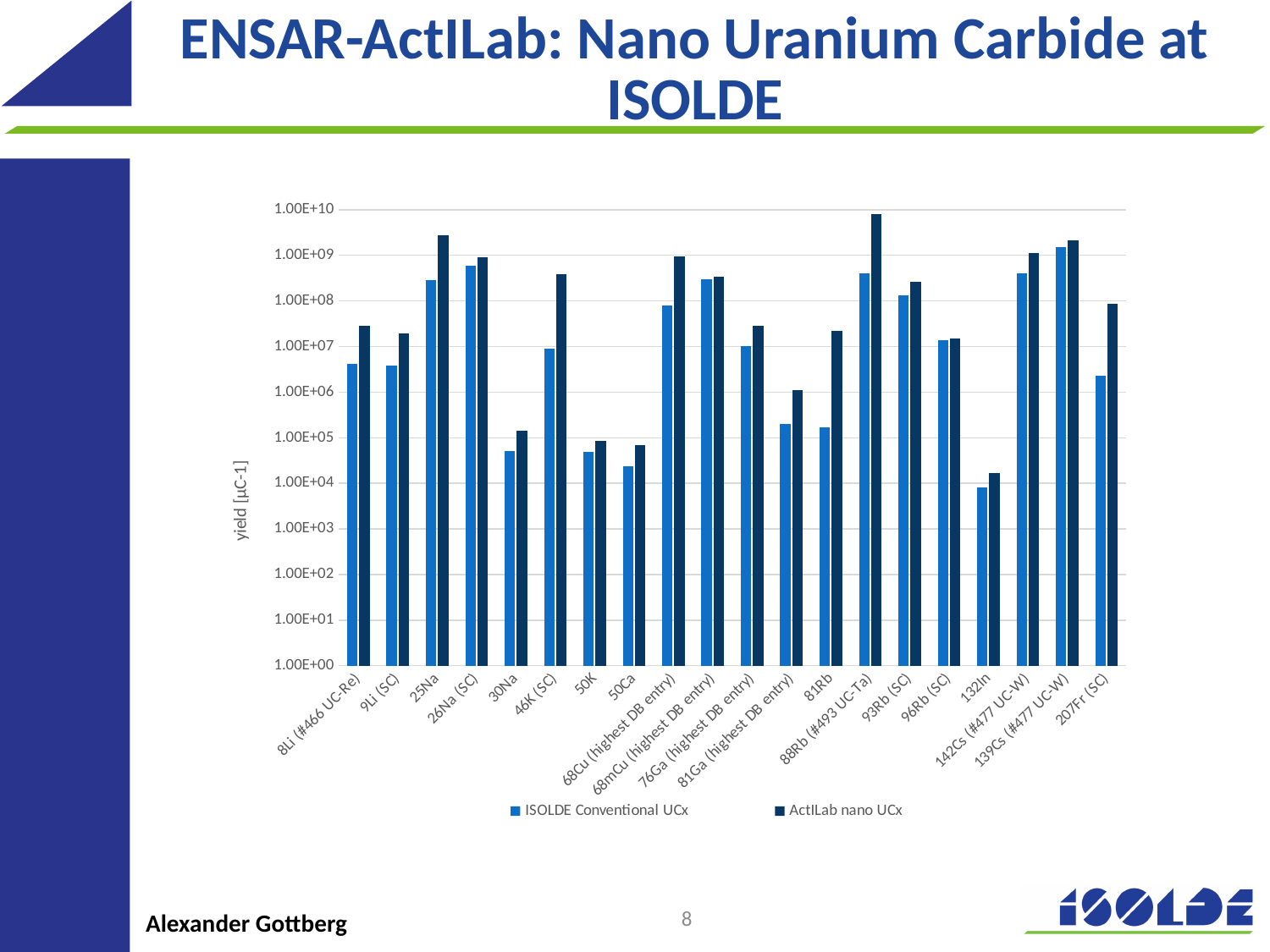
How many isotope categories are plotted along the x axis? 20 Is the ISOLDE Conventional UCx yield for 8Li (#466 UC-Re) greater or less than 1.00E+06? greater Which has the larger ISOLDE Conventional UCx yield: 139Cs (#477 UC-W) or 132In? 139Cs (#477 UC-W) Which category has the lowest ISOLDE Conventional UCx yield? 132In Which category has the highest ActILab nano UCx yield? 88Rb (#493 UC-Ta) Is the ISOLDE Conventional UCx yield for 30Na greater or less than 1.00E+05? less What kind of chart is shown on the slide? bar chart For 88Rb (#493 UC-Ta), which series has the larger yield: ISOLDE Conventional UCx or ActILab nano UCx? ActILab nano UCx What is the label of the y axis? yield [µC-1] How many series does the legend list? 2 Is the ActILab nano UCx yield for 25Na greater or less than 1.00E+09? greater